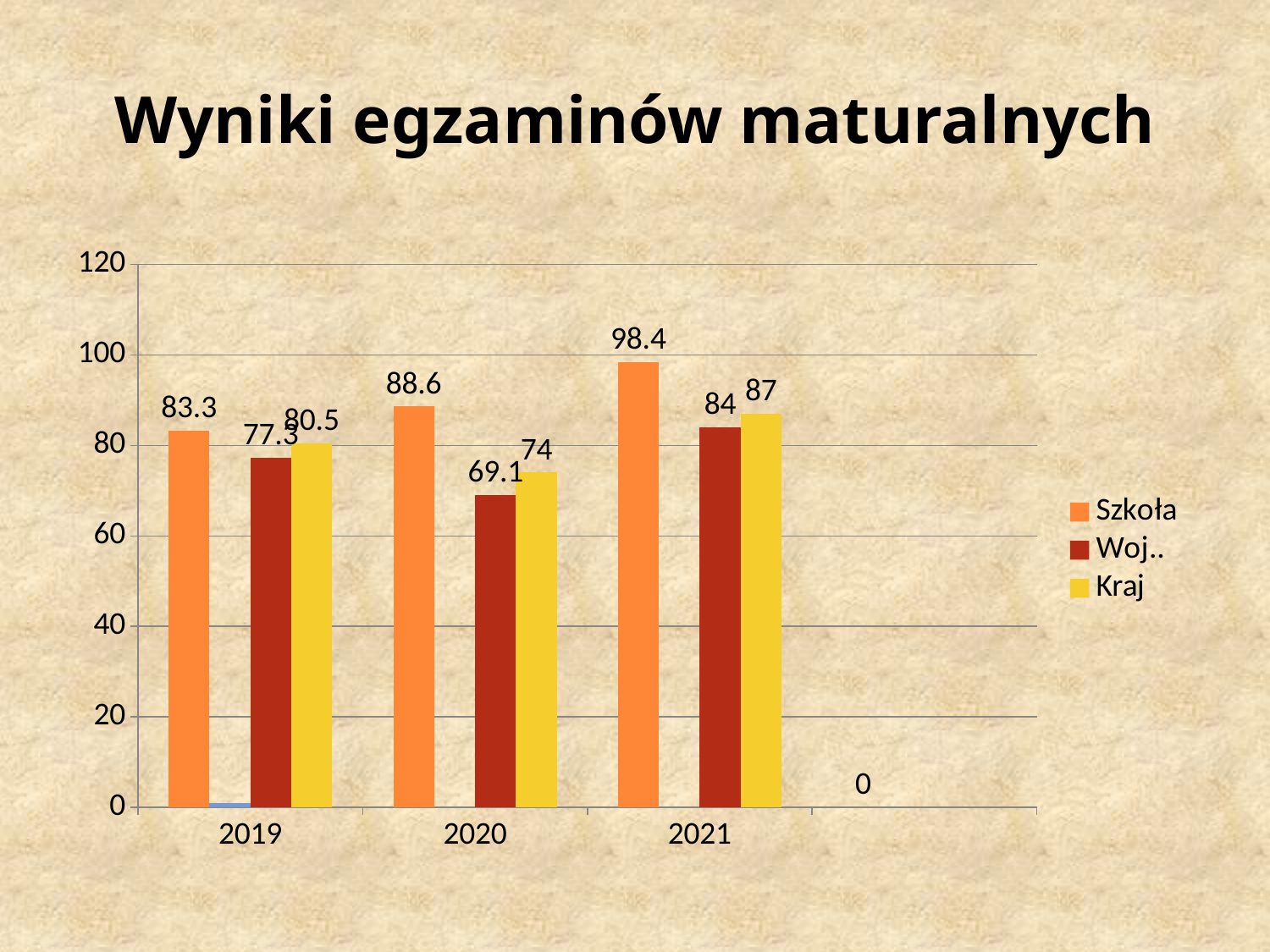
What is the value for Woj.. in 2020? 69.1 In which year is the Woj.. value lowest? 2020 What is the title of the chart? Wyniki egzaminów maturalnych Which is larger in 2020: the Szkoła value or the Kraj value? Szkoła What is the value for Kraj in 2019? 80.5 What kind of chart is shown on the slide? Bar chart What is the value for Szkoła in 2019? 83.3 How many series does the legend list? 3 What is the difference between the Szkoła and Kraj values in 2021? 11.4 What is the value for Szkoła in 2021? 98.4 Do the Szkoła values rise or fall from 2019 to 2021? Rise In which year is the Szkoła value highest? 2021